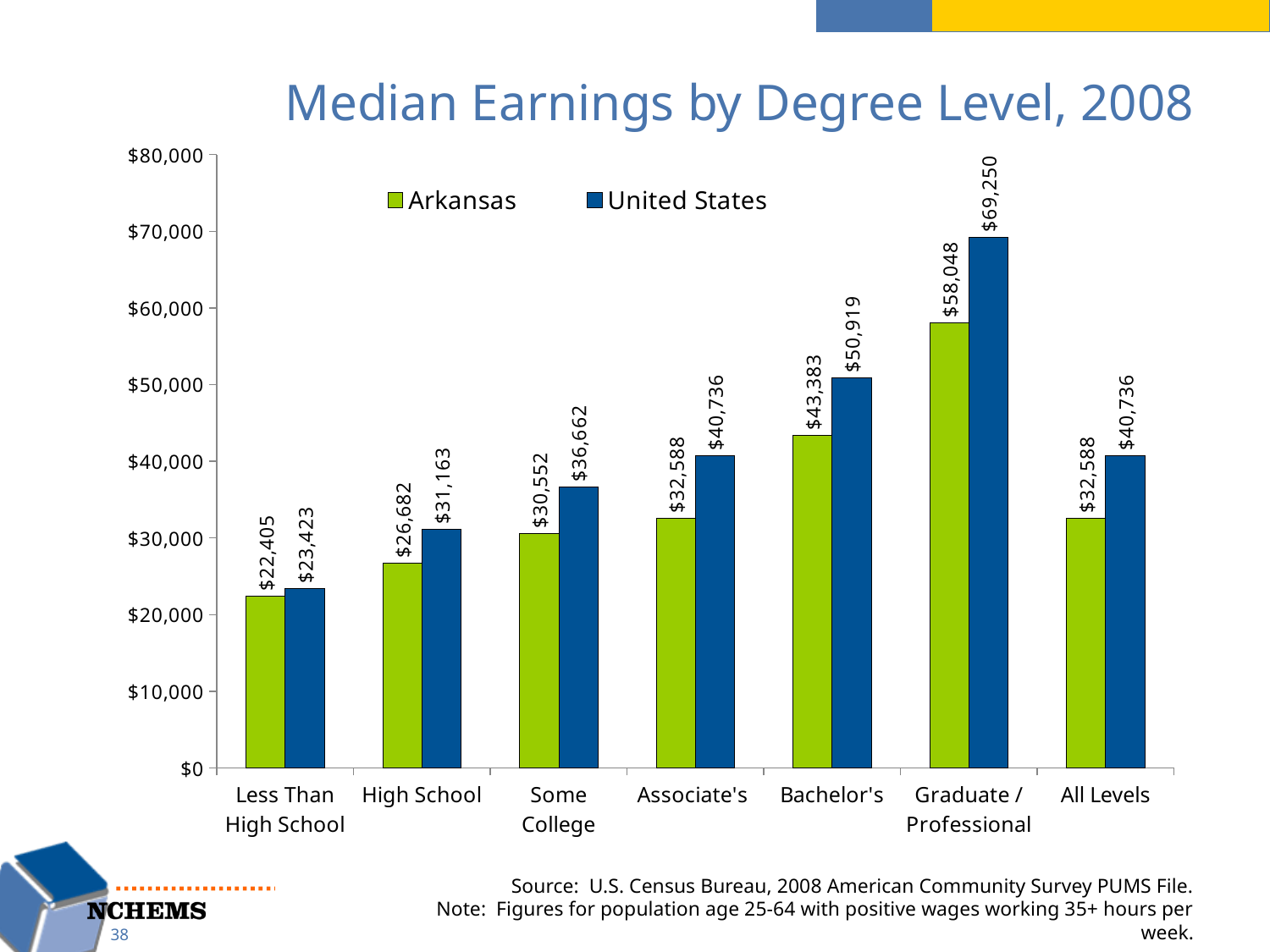
Which degree level has the highest median earnings for the United States? Graduate / Professional How many series does the legend list? 2 What is the difference between United States and Arkansas median earnings at the Graduate / Professional level? $11,202 Which degree level has the lowest median earnings for Arkansas? Less Than High School How many degree-level categories are shown on the x axis? 7 What kind of chart is shown on the slide? Bar chart What is the median earnings for Arkansas at the Bachelor's degree level? $43,383 What is the median earnings for Arkansas for Less Than High School? $22,405 Which is larger, Arkansas median earnings for Some College or United States median earnings for High School? United States median earnings for High School What is the title of the chart? Median Earnings by Degree Level, 2008 What is the difference between United States and Arkansas median earnings for All Levels? $8,148 What is the median earnings for the United States at the Graduate / Professional level? $69,250